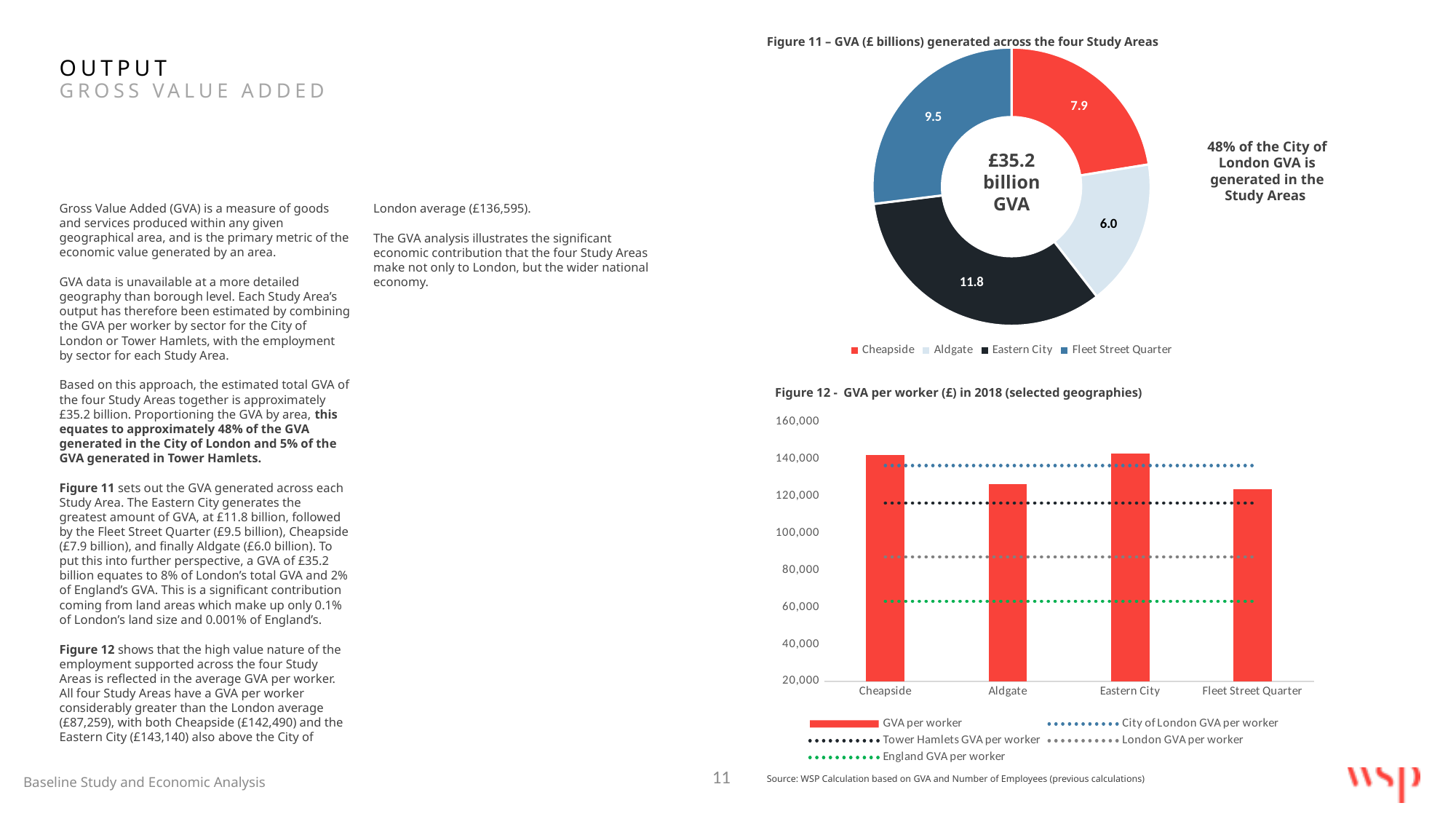
How many series does the legend of Figure 12 list? 5 In Figure 11, what total GVA is shown in the centre of the chart? £35.2 billion In Figure 11, what is the difference in GVA (£ billions) between Eastern City and Aldgate? 5.8 In Figure 11, which Study Area generates the lowest GVA? Aldgate In Figure 12, is the GVA per worker for Eastern City greater or less than 140,000? greater In Figure 12, which is larger, the GVA per worker for Cheapside or for Fleet Street Quarter? Cheapside In Figure 11, what GVA (£ billions) is shown for Aldgate? 6.0 In Figure 11, what GVA (£ billions) is shown for Eastern City? 11.8 What kind of chart is Figure 11? Doughnut (pie) chart In Figure 11, which Study Area generates the highest GVA? Eastern City In Figure 11, what GVA (£ billions) is shown for Fleet Street Quarter? 9.5 In Figure 12, is the GVA per worker for Aldgate greater or less than 140,000? less